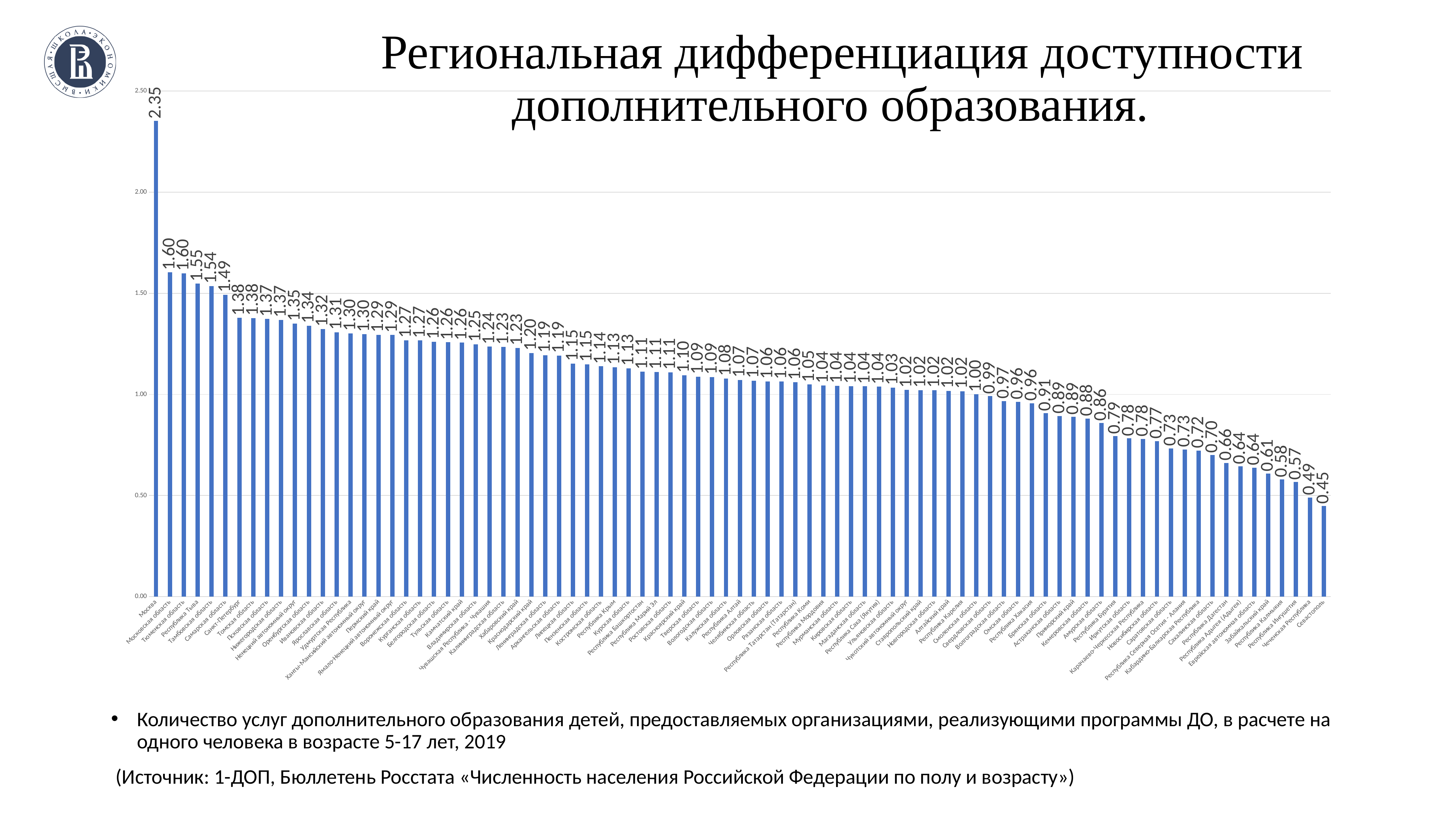
What is the value for Москва? 2.35 Do the values rise or fall from left to right along the x axis? fall What is the title of the slide containing the chart? Региональная дифференциация доступности дополнительного образования. Is the value for Москва greater or less than 2.00? greater What is the value for Московская область? 1.60 What is the difference between the values for Москва and Севастополь? 1.90 Which region has the highest value in the chart? Москва What is the value for Севастополь? 0.45 What kind of chart is shown on the slide? bar chart Which region has the lowest value in the chart? Севастополь Which is larger, the value for Москва or the value for Московская область? Москва What is the value for Республика Тыва? 1.55